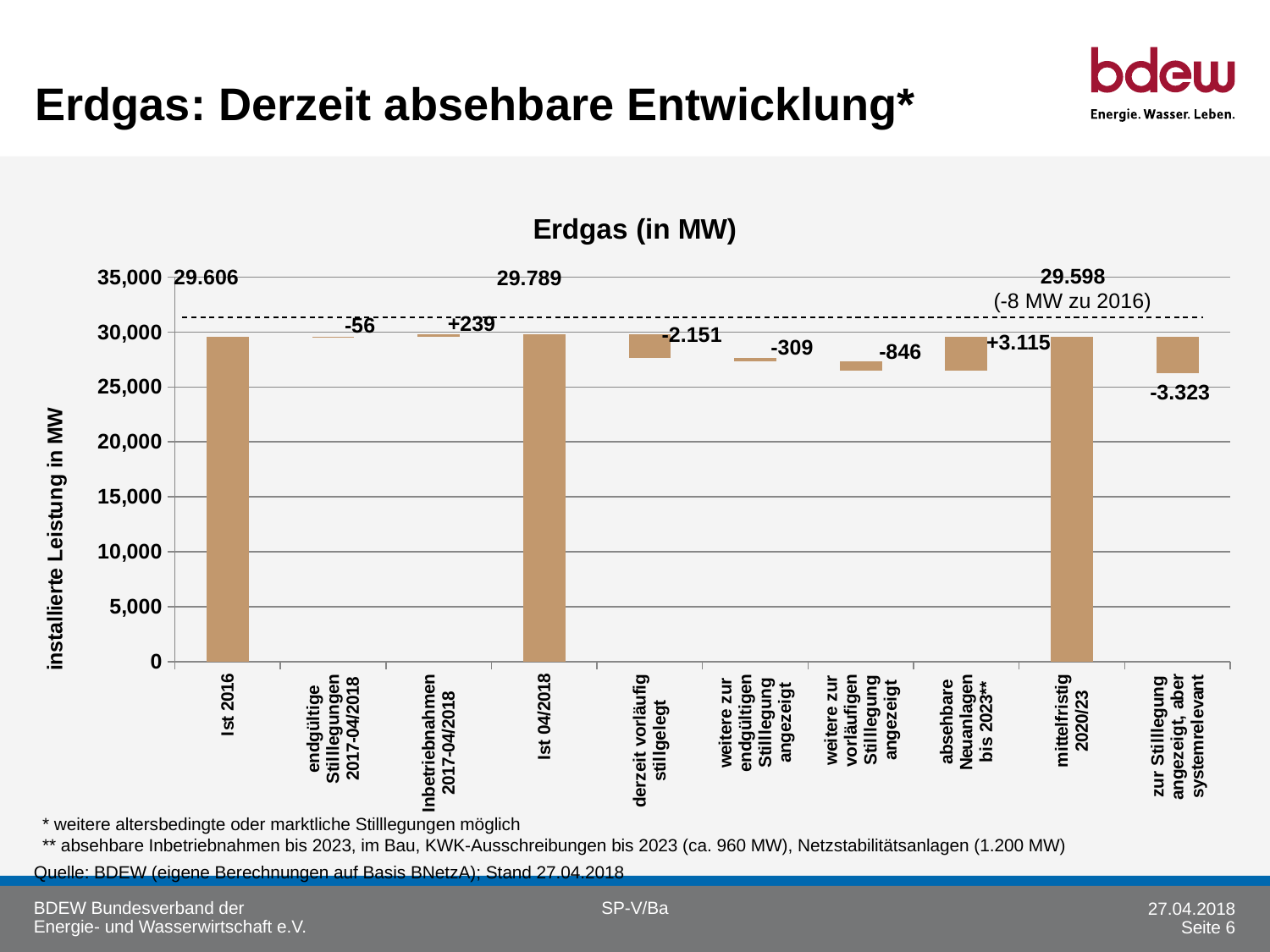
What value is shown for "Ist 04/2018"? 29.789 What is the difference between the values for "Ist 04/2018" and "Ist 2016"? 183 Which category shows the largest reduction (most negative labelled value)? zur Stilllegung angezeigt, aber systemrelevant How many categories are shown on the x axis? 10 Which category has the highest installed capacity value? Ist 04/2018 Is the value for "Ist 2016" greater or less than 25,000? greater Which is larger, the value for "Ist 2016" or for "mittelfristig 2020/23"? Ist 2016 What value is labelled on the bar for "absehbare Neuanlagen bis 2023**"? +3.115 What value is shown for "Ist 2016"? 29.606 What is the title of the chart? Erdgas (in MW) What value is shown for "mittelfristig 2020/23"? 29.598 What value is labelled on the bar for "derzeit vorläufig stillgelegt"? -2.151